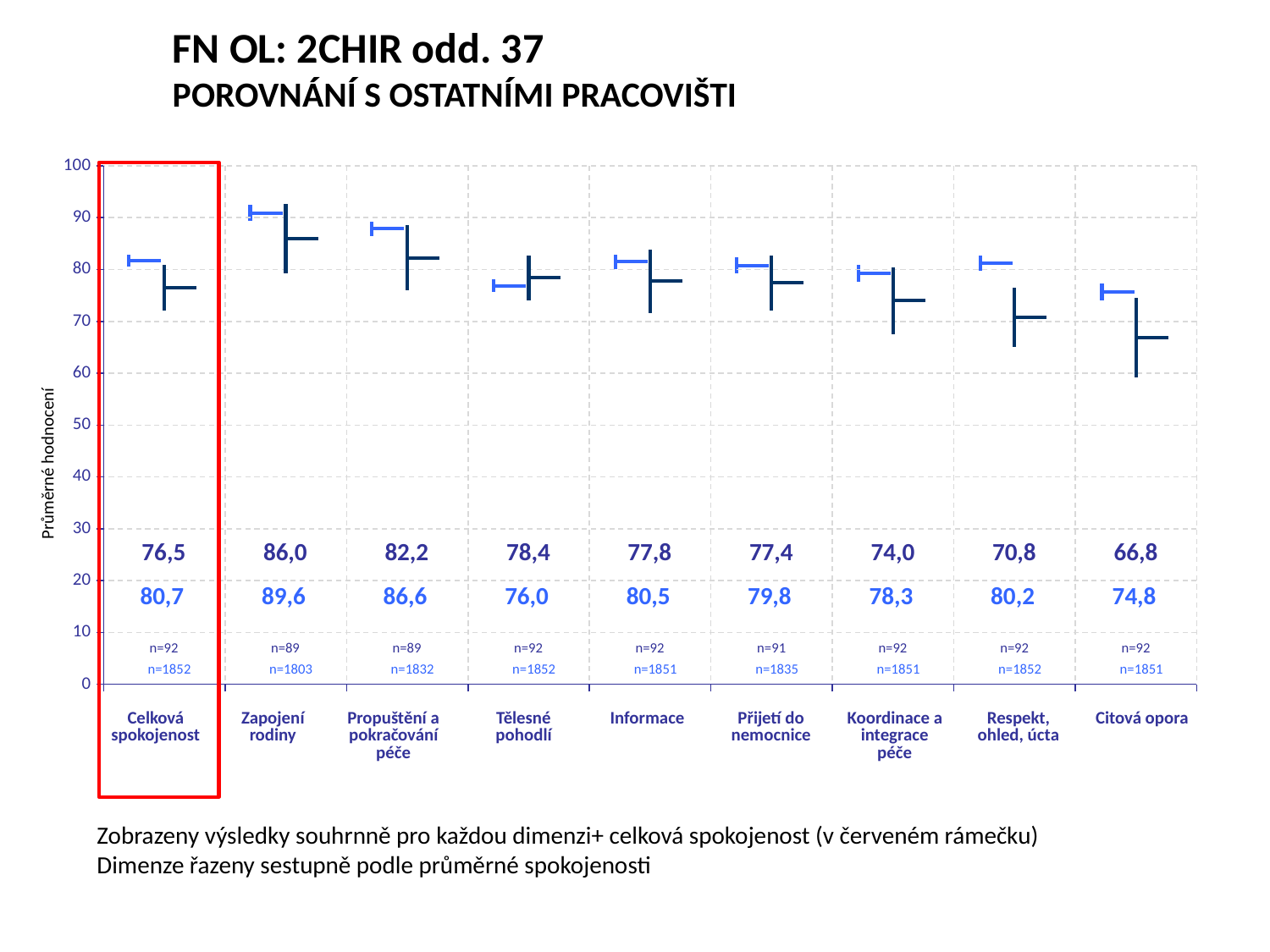
What is the light blue value shown for Zapojení rodiny? 89,6 How many dimensions are shown along the x axis of the chart? 9 What is the label of the vertical axis of the chart? Průměrné hodnocení For Tělesné pohodlí, which is larger: the dark blue value or the light blue value? the dark blue value (78,4) Is the dark blue value for Citová opora greater or less than 70? less Which dimension has the highest dark blue value? Zapojení rodiny Which dimension has the lowest dark blue value? Citová opora What is the dark blue value shown for Celková spokojenost? 76,5 Which dimension has the lowest light blue value? Citová opora What is the dark blue n value shown for Informace? n=92 For Respekt, ohled, úcta, what is the difference between the light blue value (80,2) and the dark blue value (70,8)? 9,4 For Celková spokojenost, what is the difference between the light blue value (80,7) and the dark blue value (76,5)? 4,2